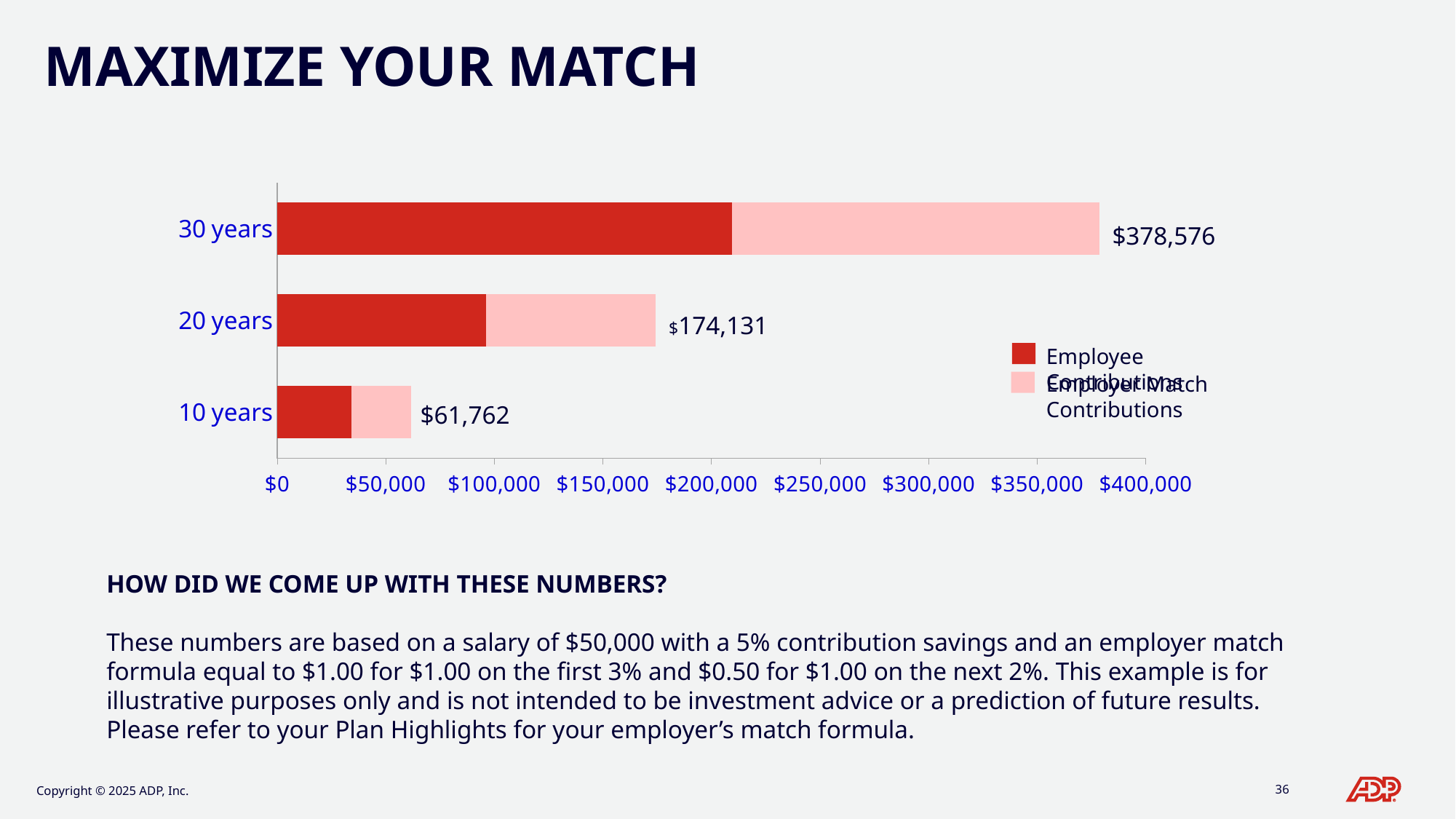
How many categories are shown on the chart? 3 What is the difference between the total for 30 years and the total for 20 years? $204,445 Is the Employee Contributions value for 10 years greater or less than $50,000? less What is the total value shown for the 30 years bar? $378,576 Which category has the lowest total value? 10 years What is the total value shown for the 10 years bar? $61,762 Is the Employee Contributions value for 30 years greater or less than $150,000? greater What is the difference between the total for 20 years and the total for 10 years? $112,369 Which is larger, the total for 20 years or the total for 10 years? 20 years What kind of chart is shown on the slide? Stacked bar chart What is the total value shown for the 20 years bar? $174,131 Which category has the highest total value? 30 years